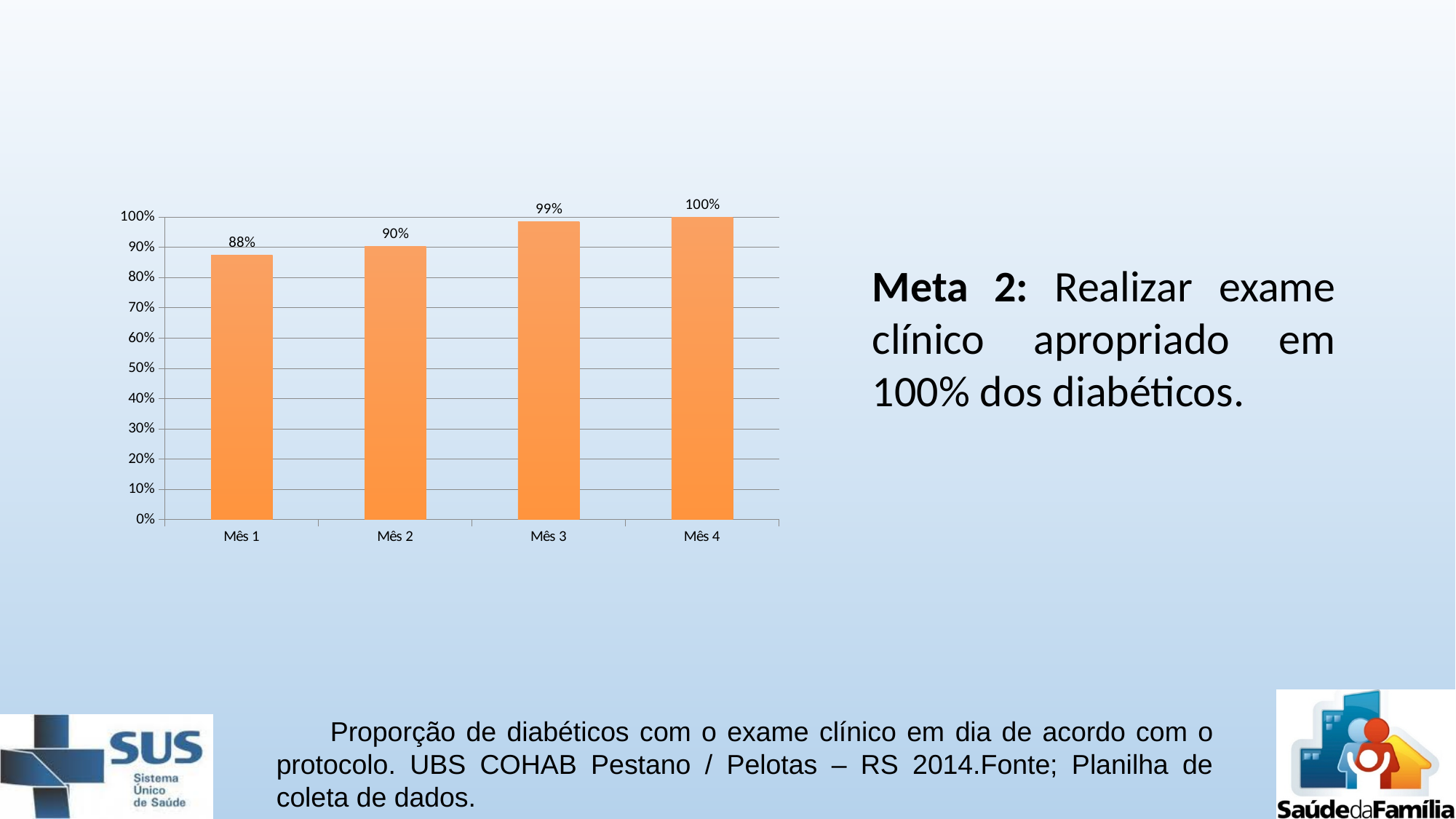
Which month has the highest value? Mês 4 What is the value for Mês 3? 99% What is the value for Mês 1? 88% How many months are shown on the x axis? 4 What is the value for Mês 2? 90% What is the value for Mês 4? 100% Which month has the lowest value? Mês 1 What is the difference between the values for Mês 3 and Mês 2? 9% Which is larger, the value for Mês 2 or the value for Mês 3? Mês 3 What kind of chart is shown on the slide? Bar chart Do the values rise or fall from Mês 1 to Mês 4? Rise What is the difference between the values for Mês 4 and Mês 1? 12%